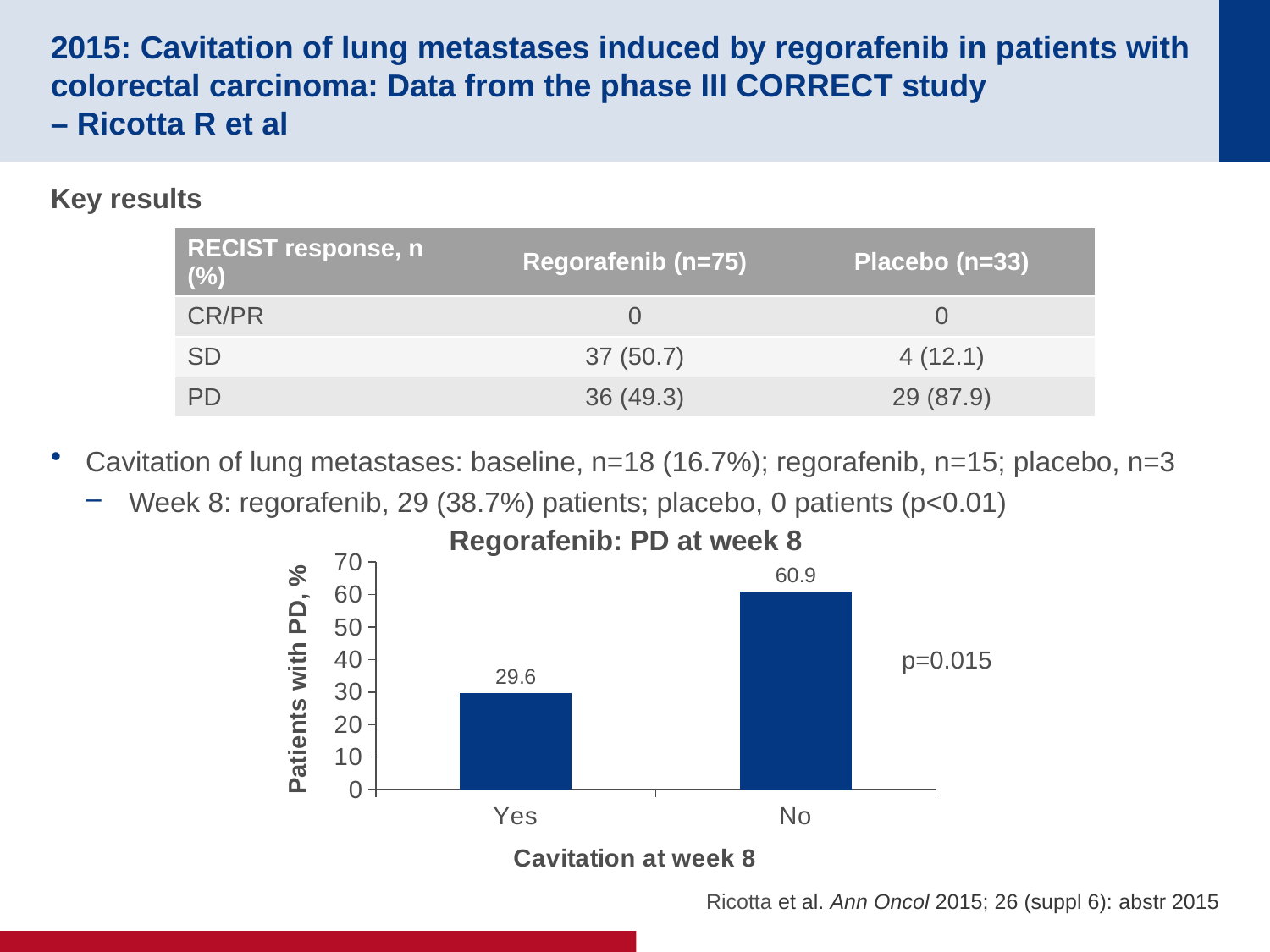
What is the value for 'Yes' cavitation at week 8 in the chart? 29.6 What is the difference between the 'No' and 'Yes' values in the chart? 31.3 Is the value for 'Yes' greater or less than the value for 'No'? less Is the value for 'No' greater or less than 50? greater What is the value for 'No' cavitation at week 8 in the chart? 60.9 What is the title of the chart? Regorafenib: PD at week 8 What kind of chart is shown on the slide? bar chart What is the label of the y axis of the chart? Patients with PD, % Which category has the lower percentage of patients with PD? Yes Which category has the higher percentage of patients with PD? No Is the value for 'Yes' greater or less than 40? less How many categories are shown on the x axis of the chart? 2